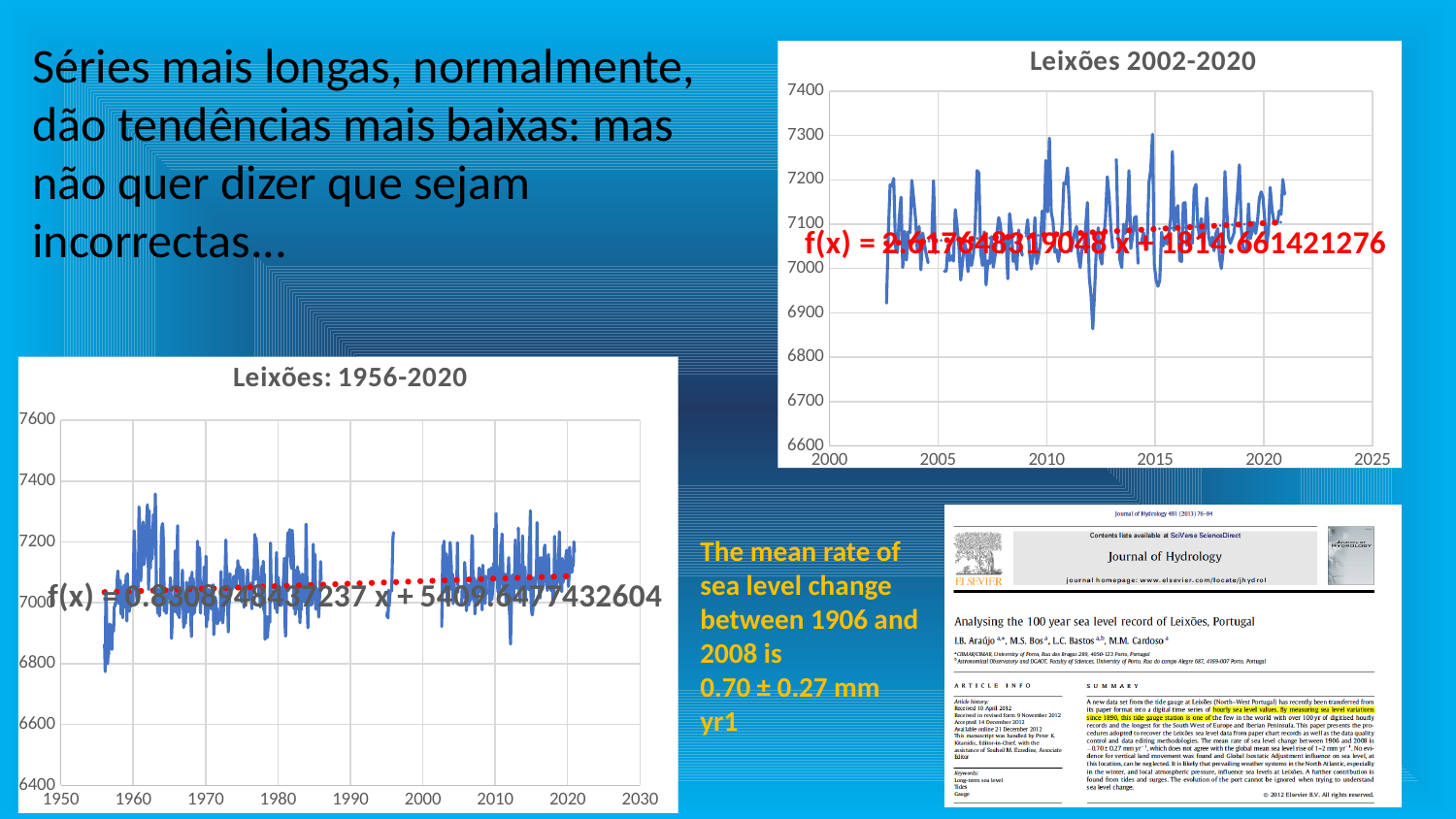
In the 'Leixões: 1956-2020' chart, is the lowest value of the series greater or less than 6800? less In the 'Leixões 2002-2020' chart, does the dotted trend line rise or fall from left to right? rise In the 'Leixões 2002-2020' chart, is the lowest value of the series greater or less than 6900? less What kind of chart is the 'Leixões 2002-2020' chart on the top right? line chart What kind of chart is the 'Leixões: 1956-2020' chart on the bottom left? line chart In the 'Leixões: 1956-2020' chart, does the dotted trend line rise or fall from left to right? rise What is the title of the chart on the top right of the slide? Leixões 2002-2020 In the 'Leixões 2002-2020' chart, is the highest value of the series greater or less than 7200? greater How many charts are shown on the slide? 2 What is the title of the chart on the bottom left of the slide? Leixões: 1956-2020 What is the intercept term shown in the trend line equation on the 'Leixões 2002-2020' chart? 1814.661421276